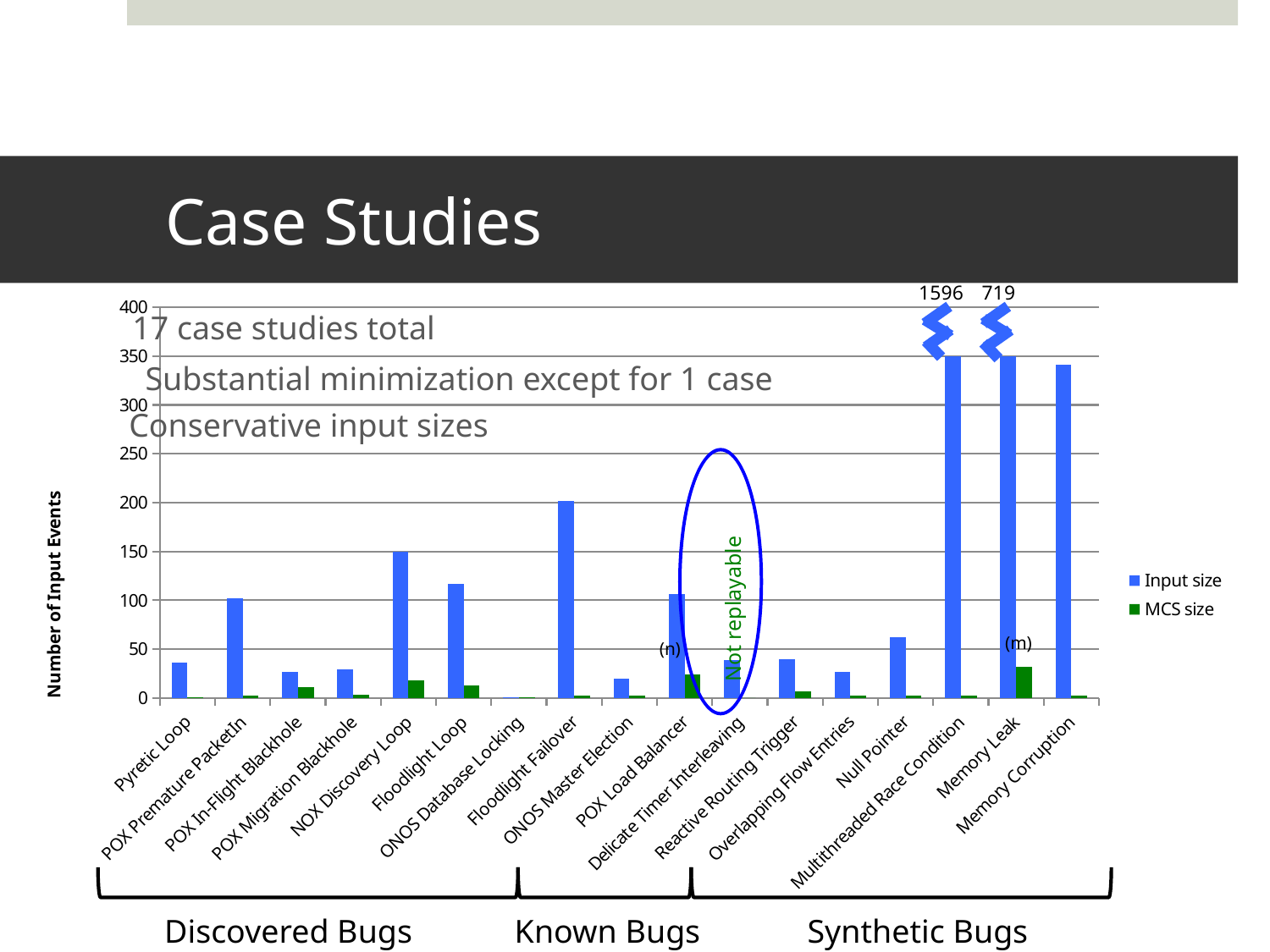
Which case study has the largest Input size? Multithreaded Race Condition How many series does the legend list? 2 What is the difference between the Input size of Multithreaded Race Condition and Memory Leak? 877 Which has a larger Input size, Floodlight Failover or POX Load Balancer? Floodlight Failover Is the Input size for Floodlight Failover greater or less than 150? greater What is the title of the y axis? Number of Input Events What is the Input size value printed above the Memory Leak bar? 719 Is the Input size for Memory Corruption greater or less than 300? greater What is the Input size value printed above the Multithreaded Race Condition bar? 1596 How many case studies (categories) are shown on the x axis? 17 What kind of chart is shown on the slide? bar chart Is the Input size for Pyretic Loop greater or less than 50? less